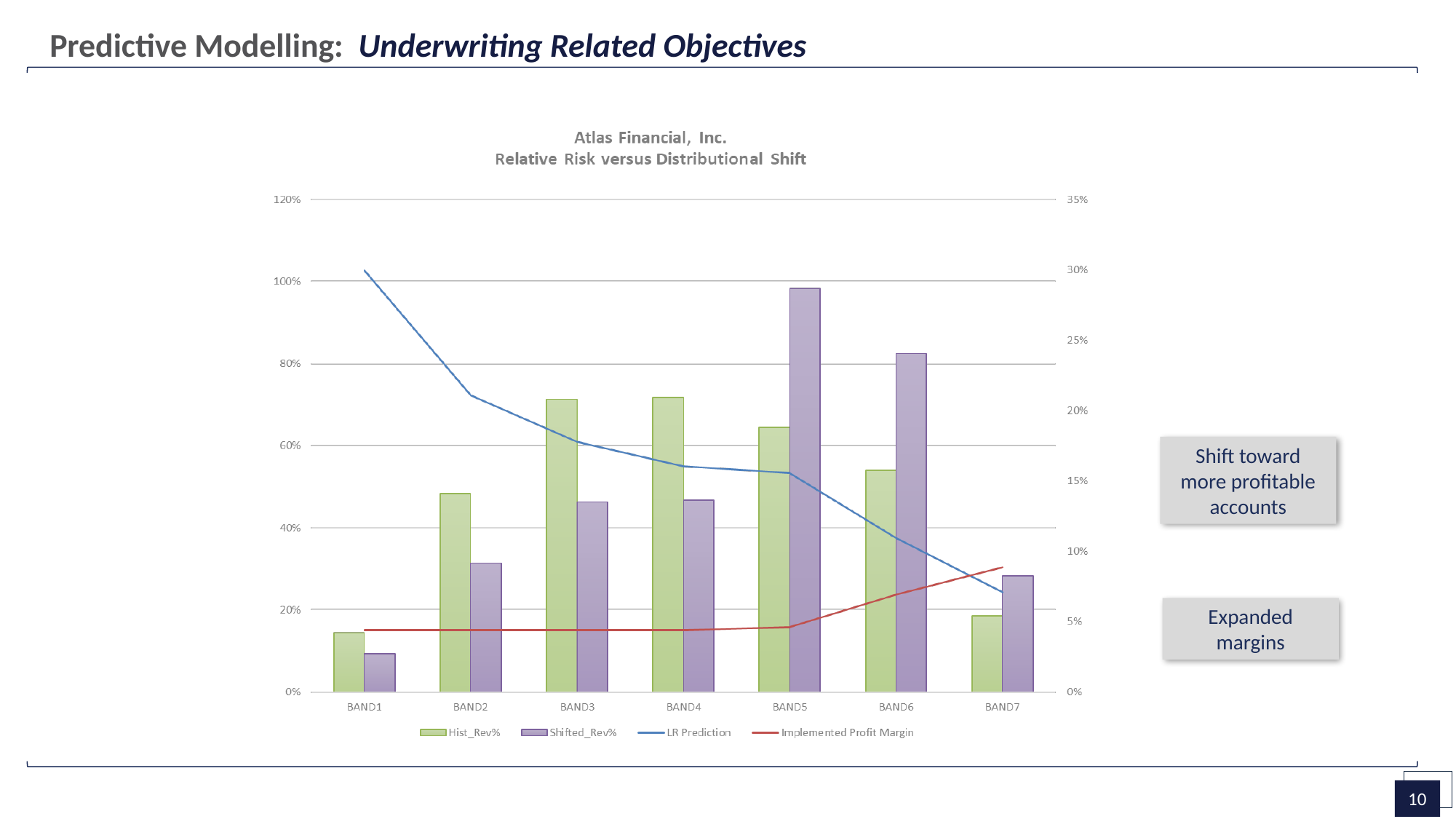
Does the LR Prediction line rise or fall from BAND1 to BAND7? Fall What kind of chart is this? Combination bar and line chart What is the title of the chart? Atlas Financial, Inc. Relative Risk versus Distributional Shift Which band has the highest Shifted_Rev% bar? BAND5 For BAND2, which is larger: Hist_Rev% or Shifted_Rev%? Hist_Rev% Which band has the lowest Shifted_Rev% bar? BAND1 Which colour represents the Hist_Rev% series? Green How many bands (categories) are shown on the x axis? 7 Is the Hist_Rev% value for BAND1 greater or less than 20%? less How many series does the chart legend list? 4